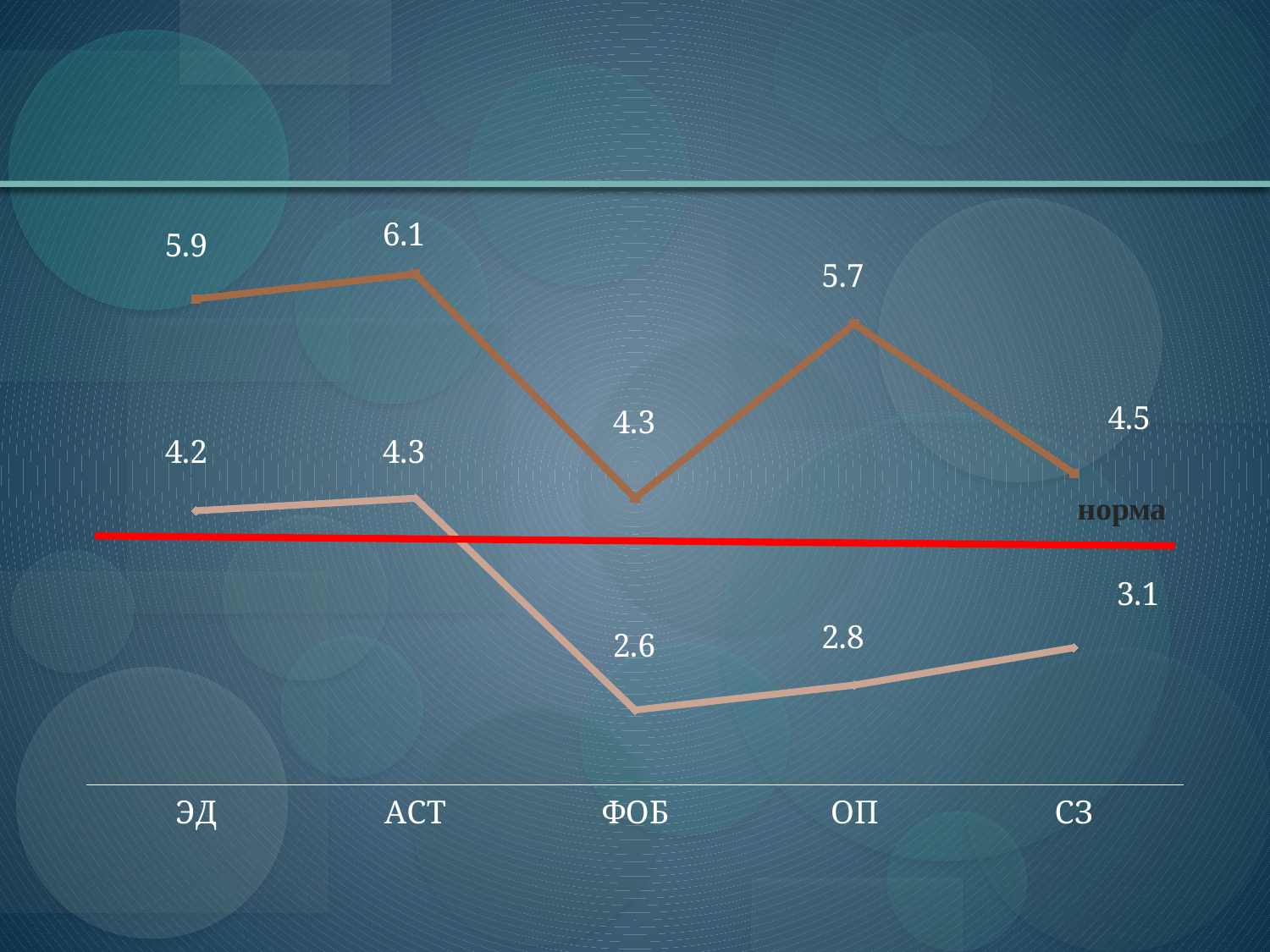
At which category does the upper (darker brown) line reach its highest value? АСТ What type of chart is shown on the slide? line chart What label is written next to the red horizontal line? норма How many categories are shown on the x axis? 5 Does the lower (lighter) line rise or fall from ФОБ to СЗ? rise What is the value of the lower (lighter) line at СЗ? 3.1 What is the difference between the upper and lower line values at ЭД? 1.7 What is the value of the upper (darker brown) line at АСТ? 6.1 What is the value of the lower (lighter) line at ФОБ? 2.6 At which category does the lower (lighter) line have its lowest value? ФОБ Which is larger for the lower (lighter) line: the value at ОП or the value at СЗ? СЗ What is the value of the upper (darker brown) line at ОП? 5.7